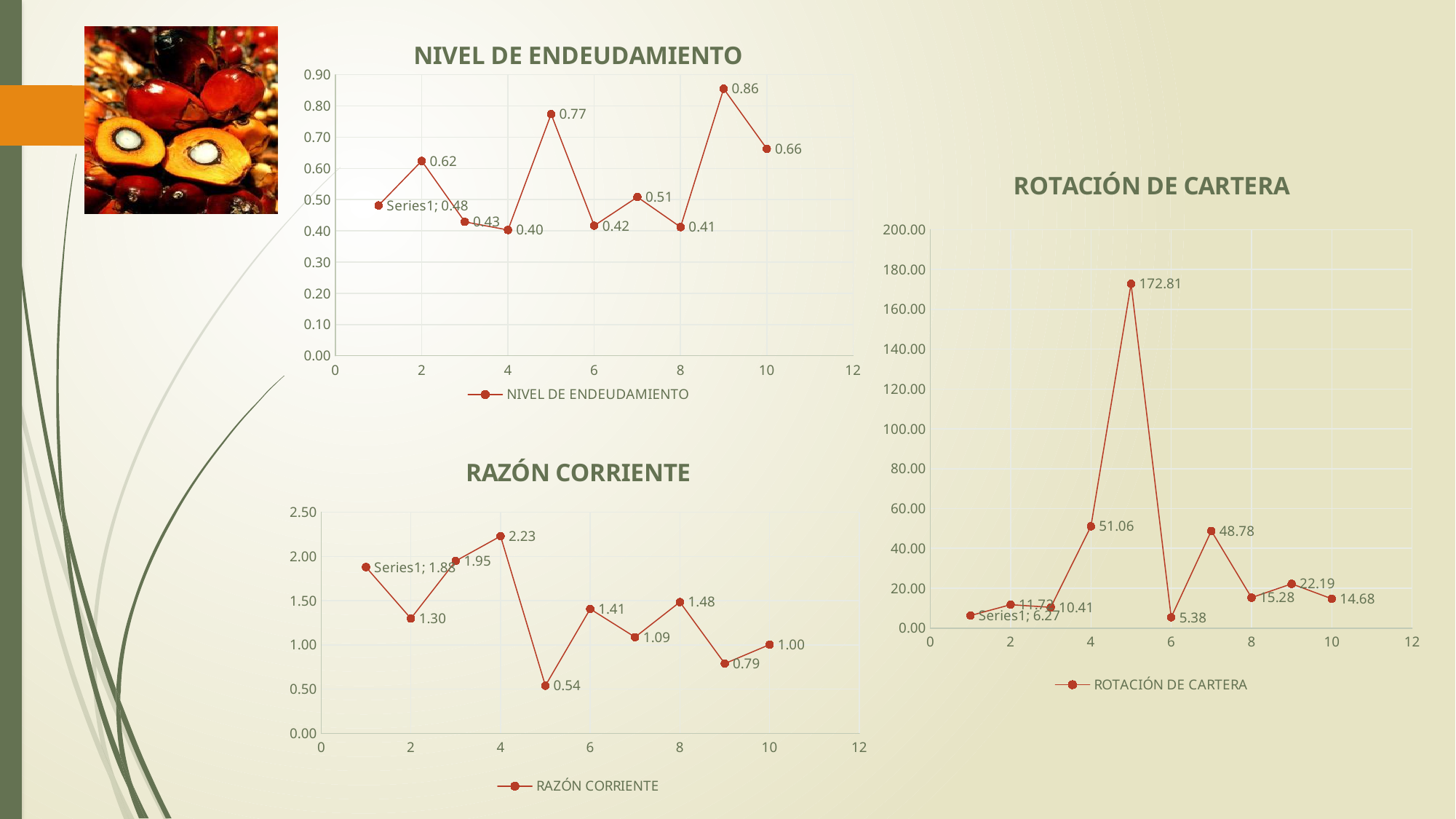
In the ROTACIÓN DE CARTERA chart, what is the difference between the values at x = 5 and x = 4? 121.75 What type of chart is the ROTACIÓN DE CARTERA chart? Line chart How many data points are plotted in the RAZÓN CORRIENTE chart? 10 In the NIVEL DE ENDEUDAMIENTO chart, what is the value at x = 5? 0.77 In the ROTACIÓN DE CARTERA chart, what is the highest value? 172.81 In the RAZÓN CORRIENTE chart, which is larger, the value at x = 2 or the value at x = 6? x = 6 In the NIVEL DE ENDEUDAMIENTO chart, what is the value at x = 9? 0.86 In the ROTACIÓN DE CARTERA chart, what is the value at x = 7? 48.78 In the NIVEL DE ENDEUDAMIENTO chart, what is the difference between the values at x = 9 and x = 10? 0.20 In the RAZÓN CORRIENTE chart, which x position has the lowest value? 5 In the RAZÓN CORRIENTE chart, what is the value at x = 4? 2.23 In the NIVEL DE ENDEUDAMIENTO chart, which x position has the lowest value? 4